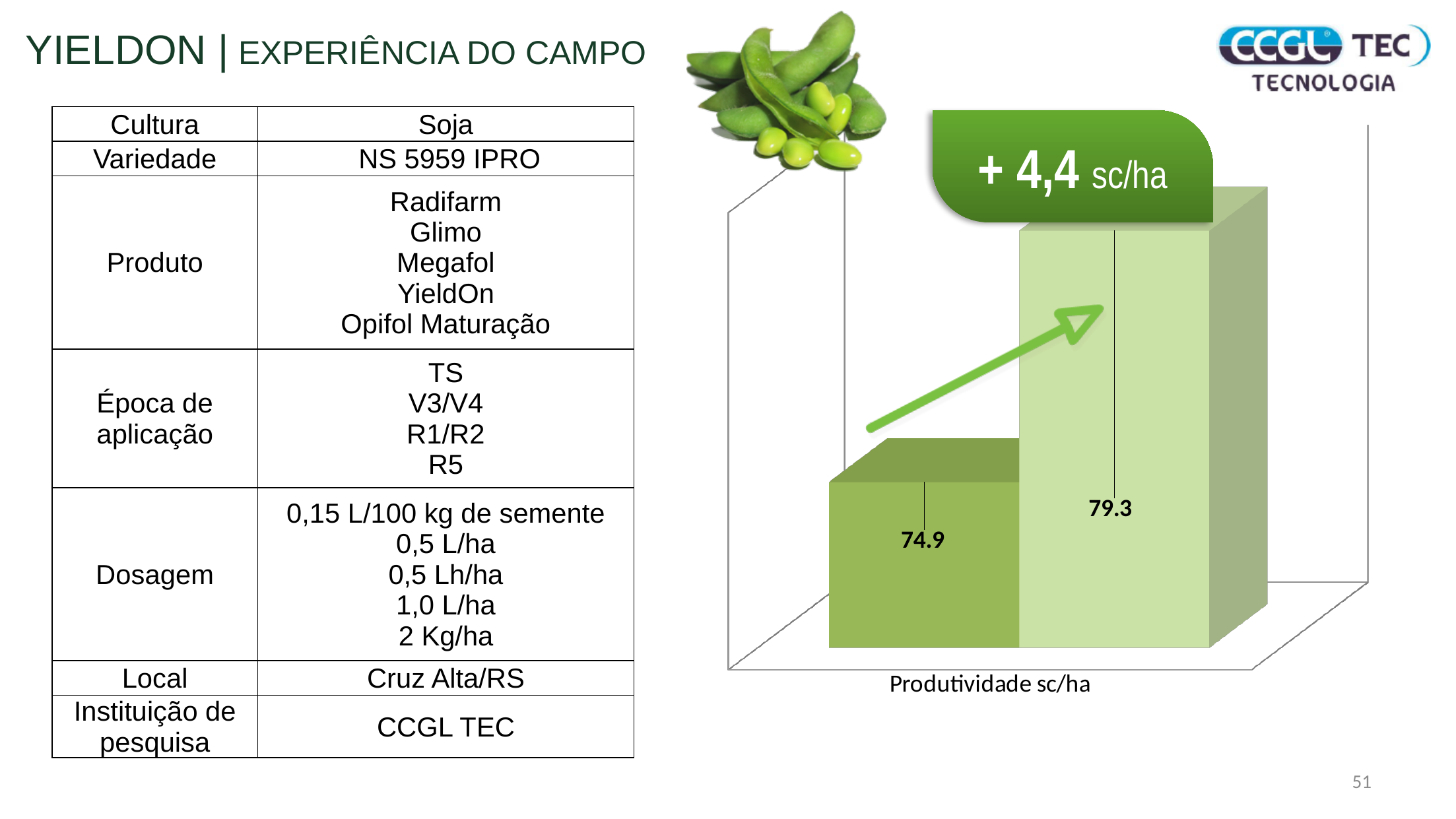
What is the highest value plotted in the chart? 79.3 What kind of chart is shown on the right side of the slide? bar chart What is the difference between the two bar values in the chart? 4.4 How many bars are plotted in the chart? 2 What gain is stated in the green callout above the chart? + 4,4 sc/ha Do the bar values rise or fall from left to right? rise Which bar is taller, the left bar or the right bar? the right bar What is the lowest value plotted in the chart? 74.9 What is the value shown on the right (lighter green) bar? 79.3 What is the value shown on the left (darker green) bar? 74.9 What is the axis label printed below the bars? Produtividade sc/ha